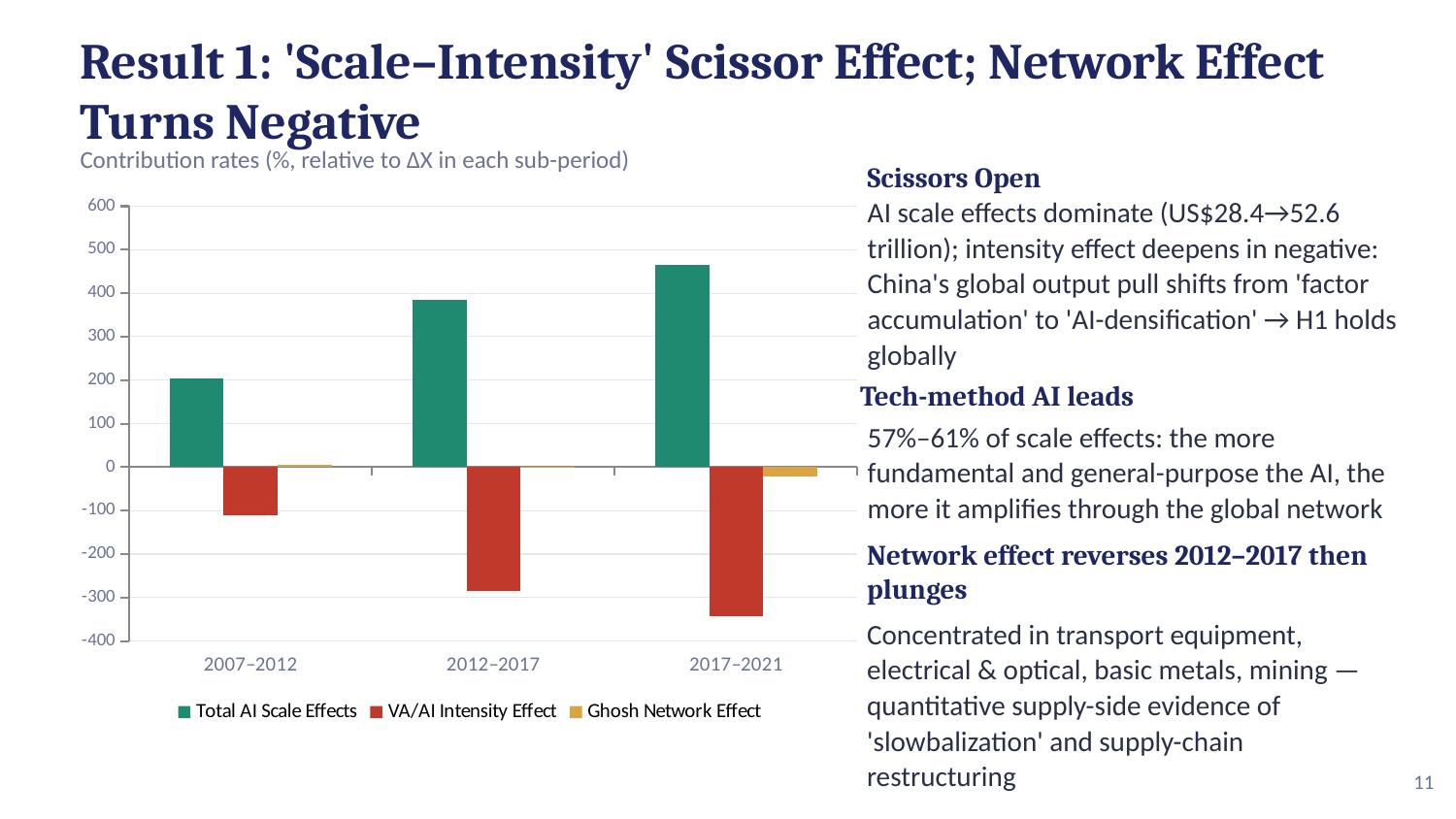
Is the VA/AI Intensity Effect value for 2017–2021 greater or less than -300? less What kind of chart is shown on the slide? bar chart In which sub-period is the VA/AI Intensity Effect bar the lowest (most negative)? 2017–2021 How many sub-periods are shown on the x axis of the chart? 3 Is the Total AI Scale Effects value for 2017–2021 greater or less than 400? greater How many series does the chart legend list? 3 Which series is shown in red in the chart legend? VA/AI Intensity Effect Do the Total AI Scale Effects values rise or fall across the sub-periods from 2007–2012 to 2017–2021? rise Which is larger: the Total AI Scale Effects value for 2012–2017 or for 2007–2012? 2012–2017 Is the VA/AI Intensity Effect value for 2007–2012 greater or less than -200? greater In which sub-period is the Total AI Scale Effects bar the highest? 2017–2021